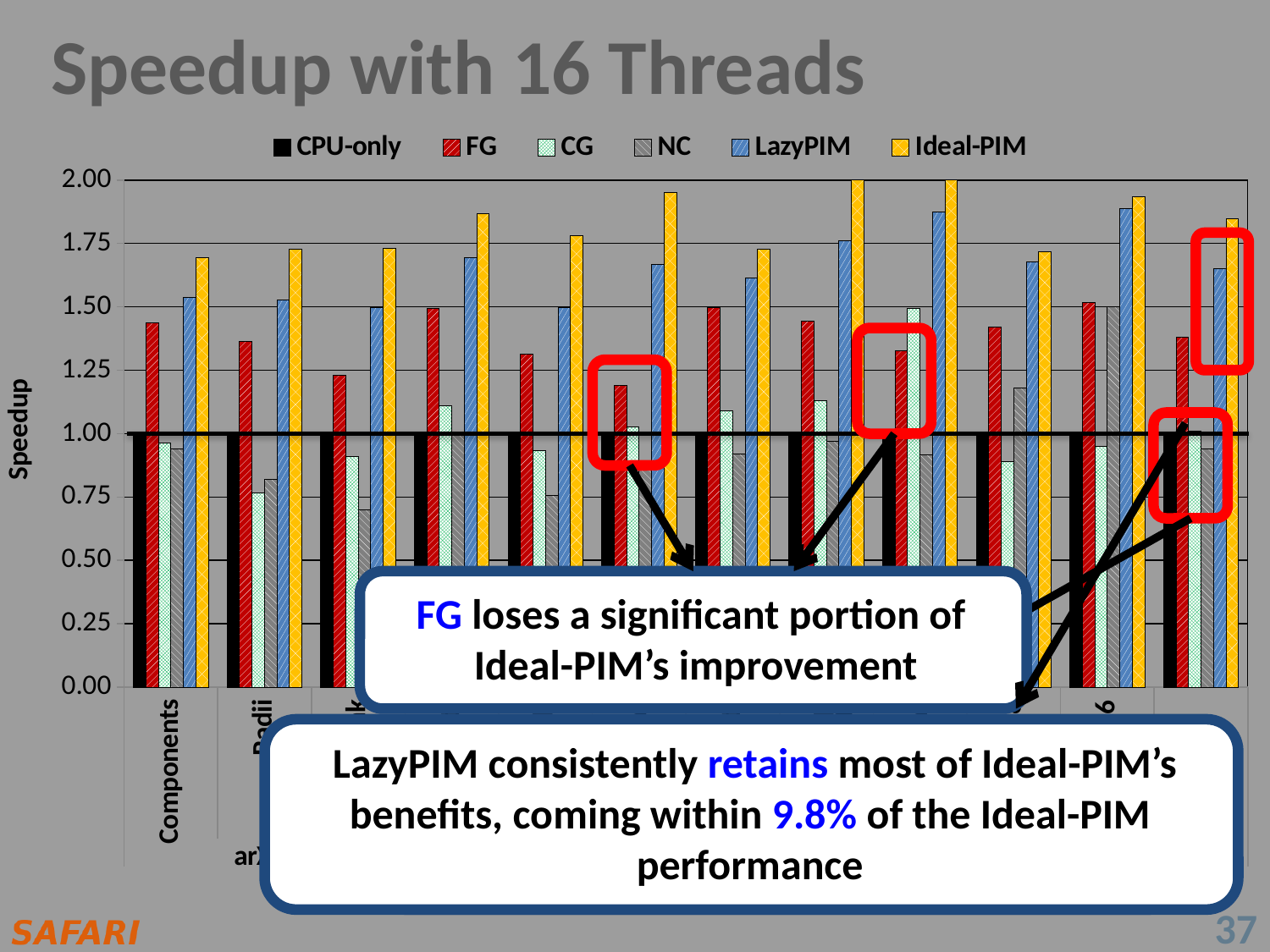
Is the FG speedup for Components greater or less than 1.25? greater Is the Ideal-PIM speedup for Radii greater or less than 1.50? greater What is the CPU-only speedup for Components? 1.00 Is the CG speedup for Radii greater or less than 1.00? less What is the title of the slide's chart? Speedup with 16 Threads For Components, which is larger: the FG speedup or the CG speedup? FG How many series does the legend list? 6 What is the label on the y axis? Speedup Which series has the highest speedup for Components? Ideal-PIM For Radii, which is larger: the Ideal-PIM speedup or the FG speedup? Ideal-PIM What kind of chart is shown on the slide? bar chart